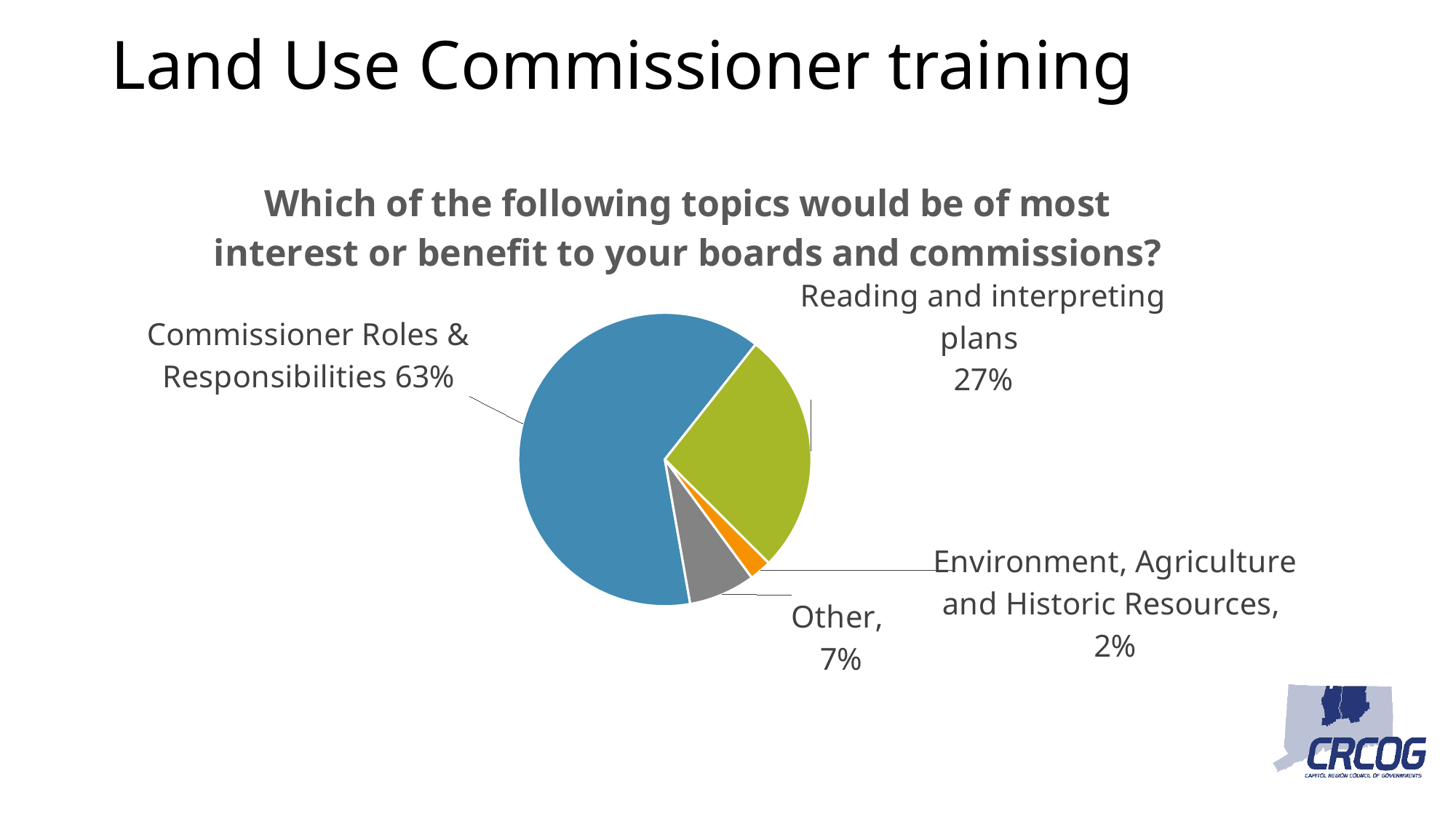
How many slices does the pie chart have? 4 What share of the pie does Commissioner Roles & Responsibilities have? 63% What kind of chart is shown on the slide? Pie chart Which topic has the smallest slice of the pie? Environment, Agriculture and Historic Resources What share of the pie does Reading and interpreting plans have? 27% Which topic has the largest slice of the pie? Commissioner Roles & Responsibilities What is the difference in percentage points between Commissioner Roles & Responsibilities and Reading and interpreting plans? 36 Which is larger, the share for Other or the share for Environment, Agriculture and Historic Resources? Other What colour is the slice for Reading and interpreting plans? Green What is the title of the chart? Which of the following topics would be of most interest or benefit to your boards and commissions? What share of the pie does Other have? 7%